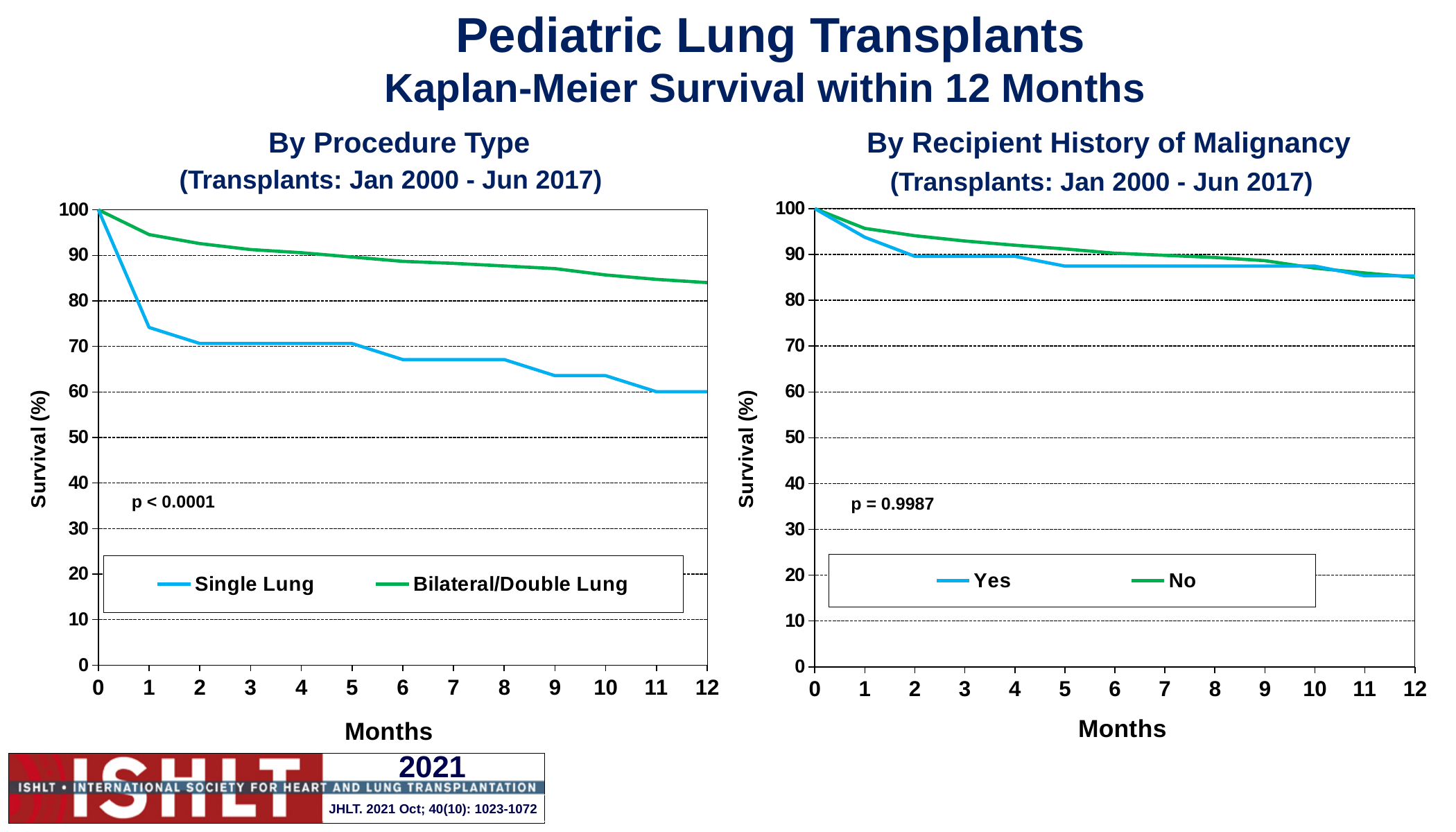
How many series does the legend of the 'By Recipient History of Malignancy' chart list? 2 What p-value is shown on the 'By Procedure Type' chart? p < 0.0001 How many series does the legend of the 'By Procedure Type' chart list? 2 In the 'By Procedure Type' chart, is the survival for Bilateral/Double Lung at 12 months greater or less than 80? greater What p-value is shown on the 'By Recipient History of Malignancy' chart? p = 0.9987 In the 'By Procedure Type' chart, what is the survival (%) for both series at 0 months? 100 What type of chart is the 'By Procedure Type' chart? line chart In the 'By Procedure Type' chart, does the Single Lung survival rise or fall as months increase? fall In the 'By Recipient History of Malignancy' chart, is the survival for Yes at 12 months greater or less than 80? greater In the 'By Procedure Type' chart, is the survival for Single Lung at 6 months greater or less than 70? less In the 'By Procedure Type' chart, which series has the higher survival at 12 months? Bilateral/Double Lung